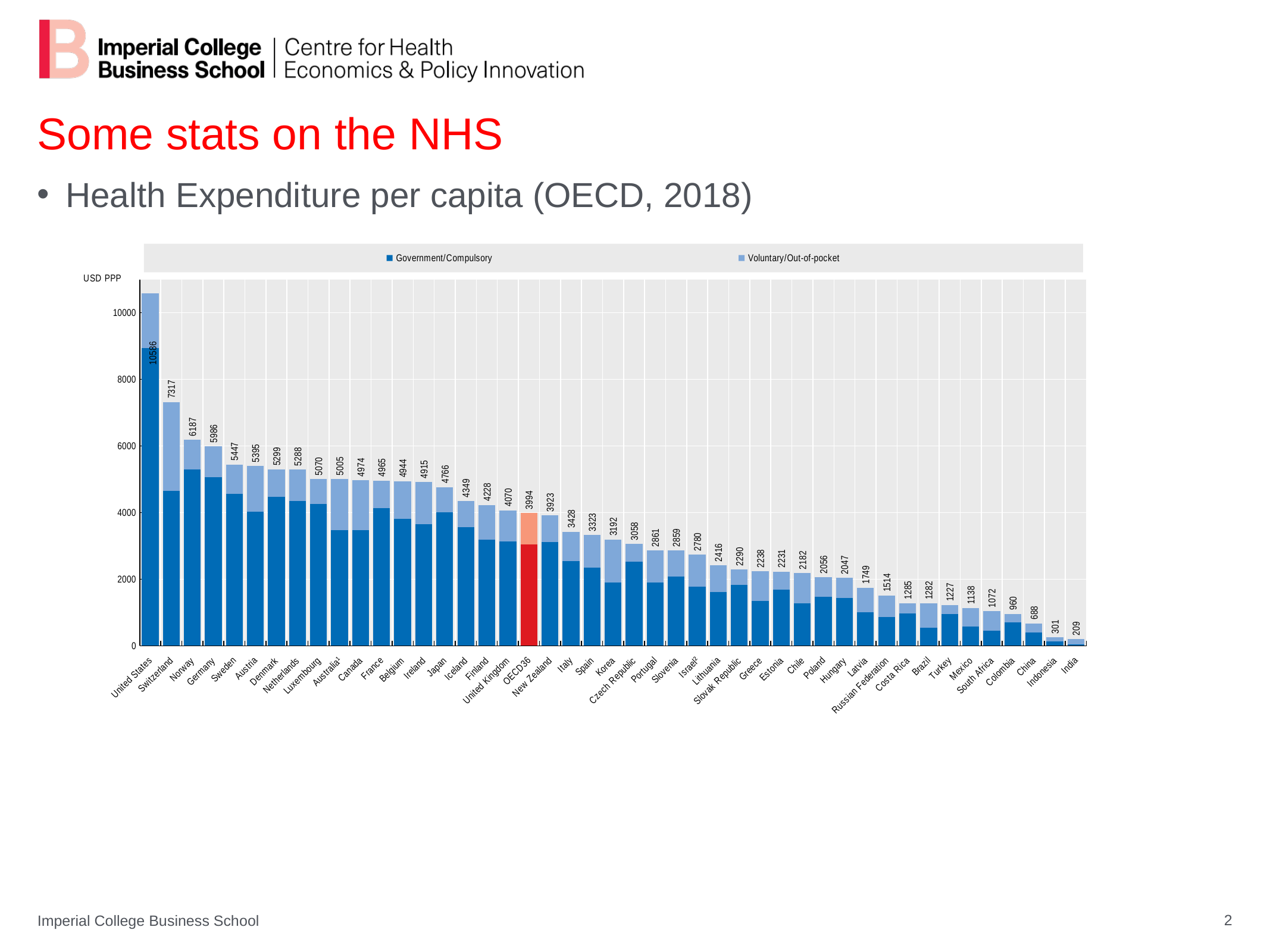
Which country has the lowest health expenditure per capita? India What is the total value shown for OECD36? 3994 Which has a higher total health expenditure per capita, Norway or Germany? Norway What kind of chart is shown on the slide? Stacked bar chart What is the total health expenditure per capita for the United Kingdom? 4070 Do the total values rise or fall moving from left to right along the x axis? Fall What is the total health expenditure per capita for the United States? 10586 Is the Government/Compulsory value for the United Kingdom greater or less than 4000? less What is the difference between the total for the United States and the total for the United Kingdom? 6516 How many series does the legend list? 2 Is the Government/Compulsory value for the United States greater or less than 8000? greater Which country has the highest health expenditure per capita? United States